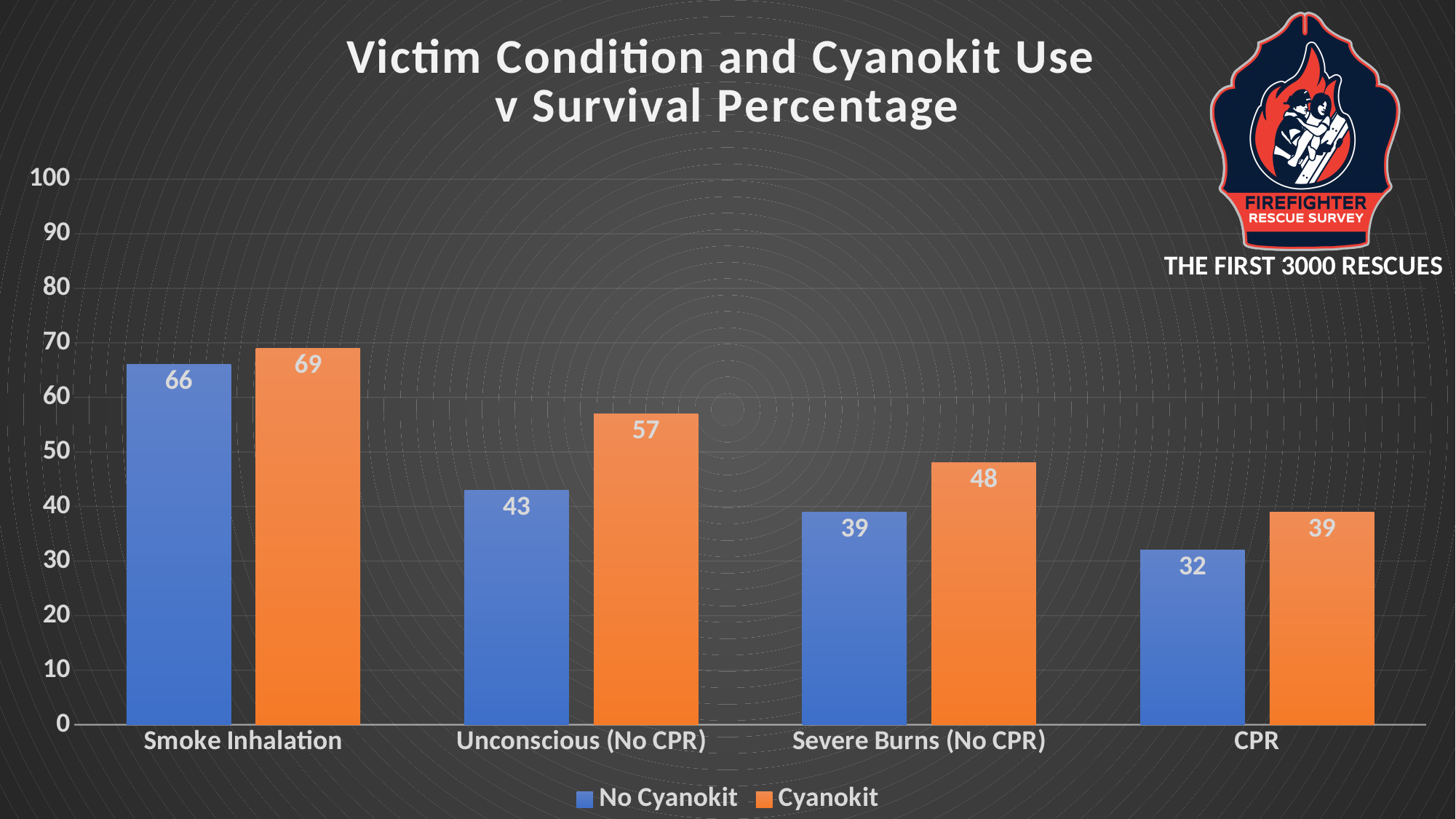
What is the survival percentage for Unconscious (No CPR) with Cyanokit? 57 What is the survival percentage for CPR with No Cyanokit? 32 What is the survival percentage for Smoke Inhalation with No Cyanokit? 66 Which is larger: the No Cyanokit value for Unconscious (No CPR) or the Cyanokit value for CPR? No Cyanokit value for Unconscious (No CPR) How many victim condition categories are shown on the x axis? 4 What kind of chart is shown on the slide? Bar chart What is the difference between the Cyanokit and No Cyanokit survival percentages for Severe Burns (No CPR)? 9 Which victim condition has the lowest survival percentage in the No Cyanokit series? CPR Do the No Cyanokit survival percentages rise or fall from Smoke Inhalation to CPR along the x axis? Fall How many series does the legend list? 2 Which victim condition has the highest survival percentage in the Cyanokit series? Smoke Inhalation What is the difference between the Cyanokit and No Cyanokit survival percentages for Unconscious (No CPR)? 14